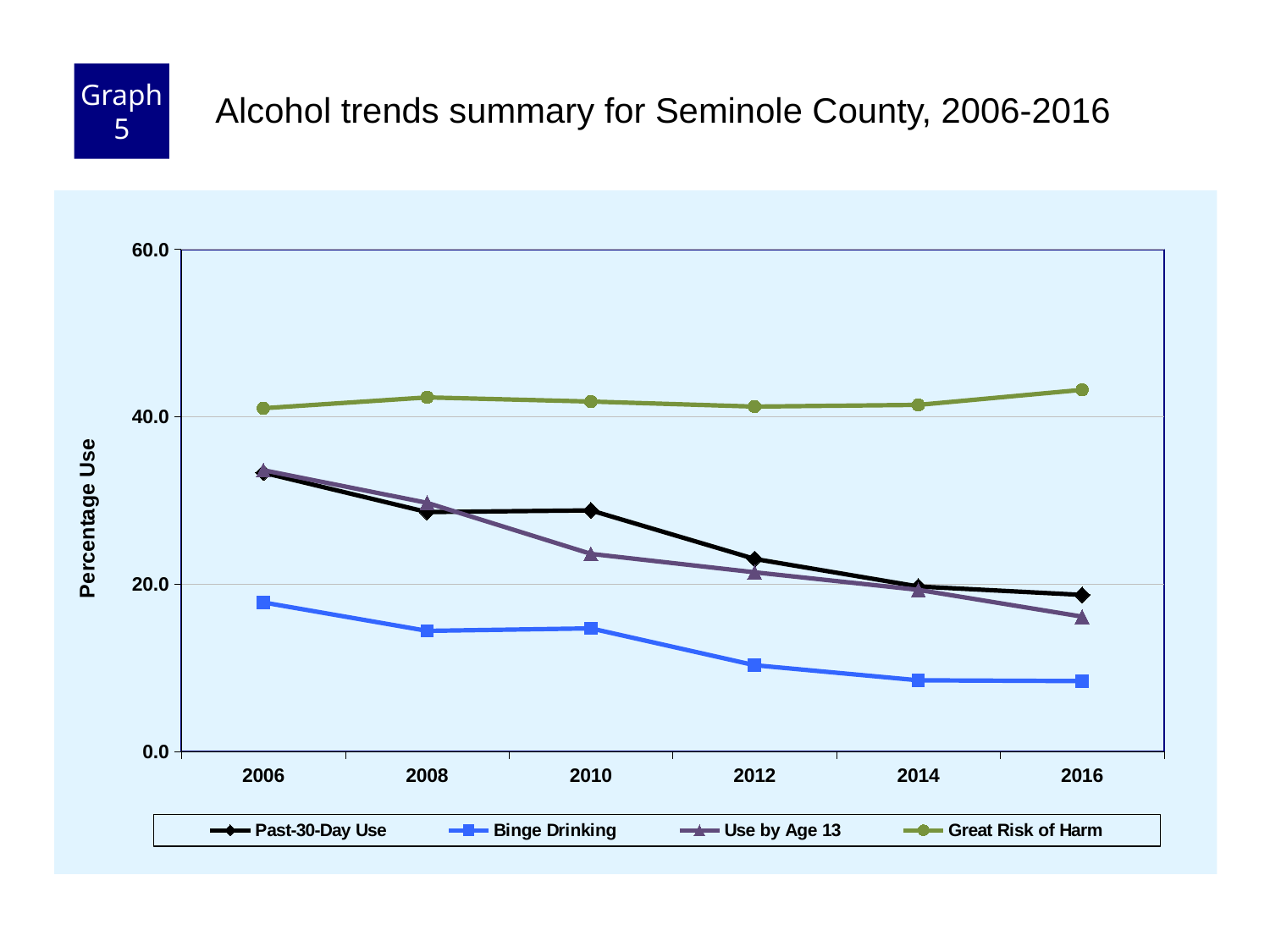
Is the value for Great Risk of Harm in 2016 greater or less than 40.0? greater Is the value for Use by Age 13 in 2016 greater or less than 20.0? less Which series has the lowest value in 2006? Binge Drinking How many years are plotted along the x axis? 6 Does the Binge Drinking series generally rise or fall from 2006 to 2016? Fall What is the label on the y axis? Percentage Use What kind of chart is shown on the slide? Line chart In 2010, which is larger: Past-30-Day Use or Use by Age 13? Past-30-Day Use Is the value for Past-30-Day Use in 2006 greater or less than 20.0? greater Which series has the highest value in 2016? Great Risk of Harm How many series does the legend list? 4